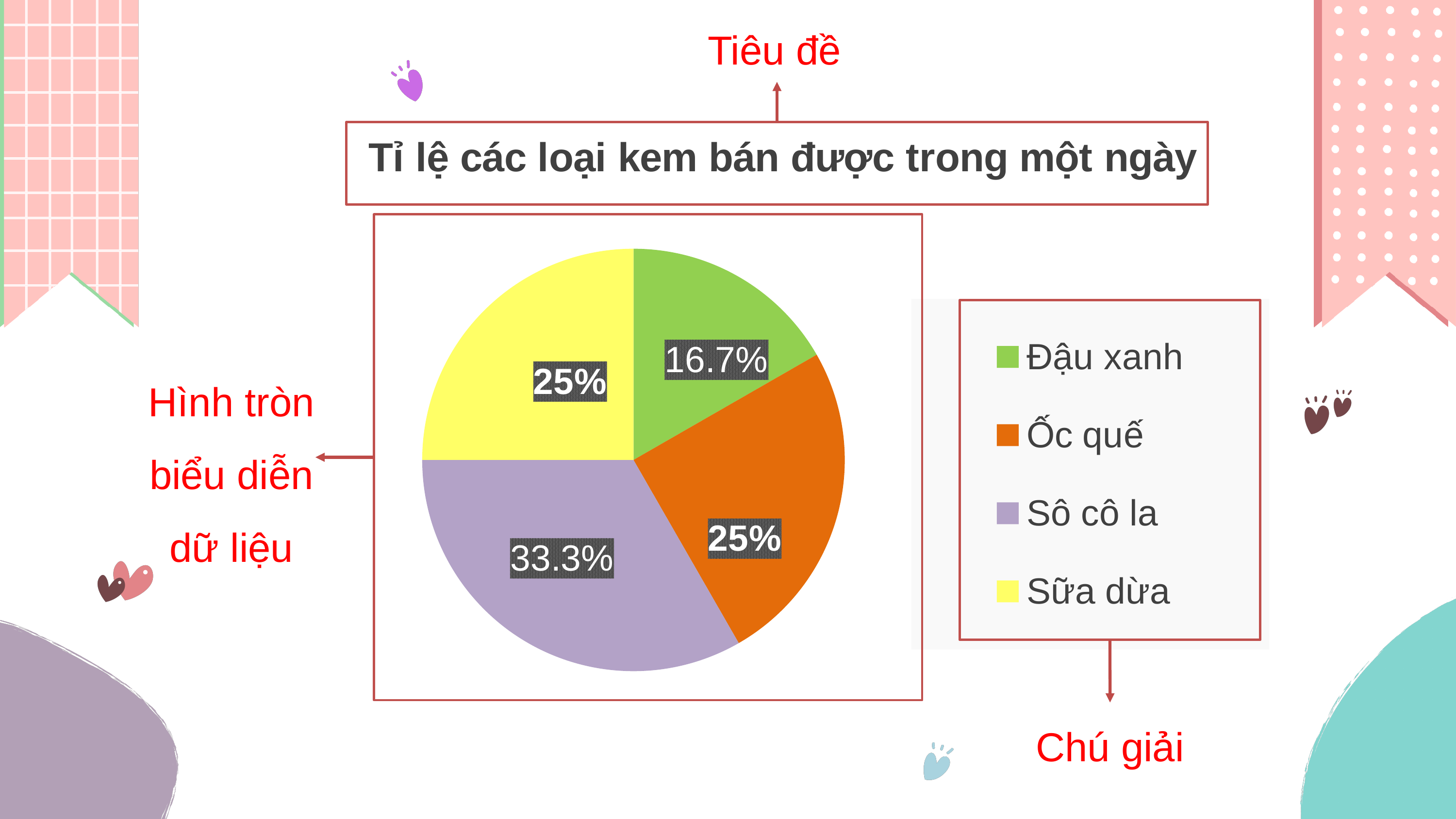
What kind of chart is shown on the slide? Pie chart Which ice cream type has the largest share? Sô cô la What share of the pie does Sô cô la have? 33.3% Which is larger, the share of Ốc quế or the share of Đậu xanh? Ốc quế Which ice cream type has the smallest share? Đậu xanh What share of the pie does Sữa dừa have? 25% What share of the pie does Ốc quế have? 25% What is the title of the chart? Tỉ lệ các loại kem bán được trong một ngày How many categories does the pie chart show? 4 What is the difference between the shares of Sô cô la and Đậu xanh? 16.6% Which colour represents Sữa dừa in the legend? Yellow